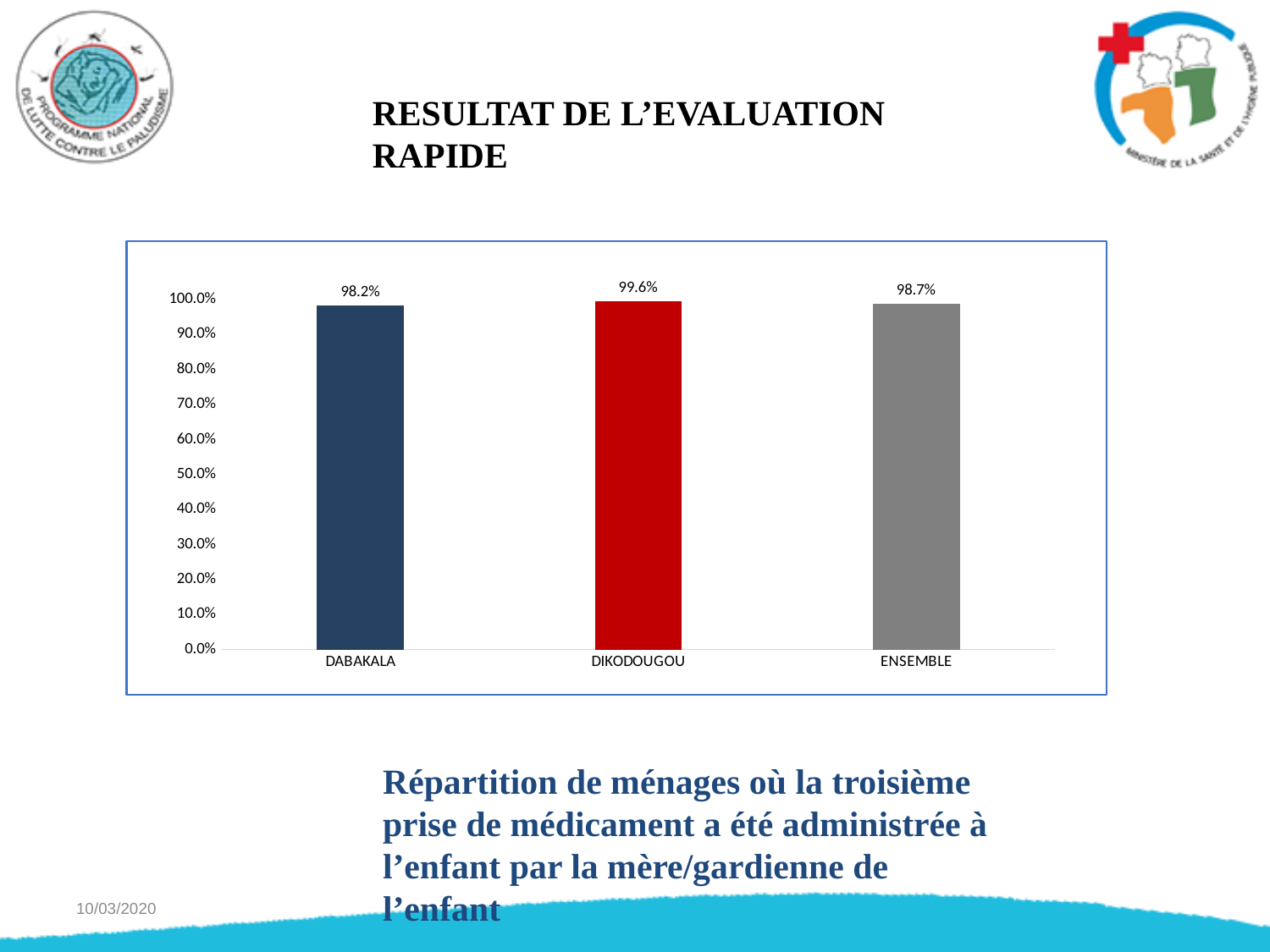
What is the value for ENSEMBLE? 98.7% Which category has the highest value? DIKODOUGOU What is the value for DIKODOUGOU? 99.6% What is the difference between the values for ENSEMBLE and DABAKALA? 0.5% What is the value for DABAKALA? 98.2% How many categories are shown on the x axis? 3 What kind of chart is shown on the slide? bar chart What is the difference between the values for DIKODOUGOU and DABAKALA? 1.4% Is the value for DABAKALA greater or less than 90.0%? greater What colour is the bar for DIKODOUGOU? red Which is larger, the value for DIKODOUGOU or the value for ENSEMBLE? DIKODOUGOU Which category has the lowest value? DABAKALA